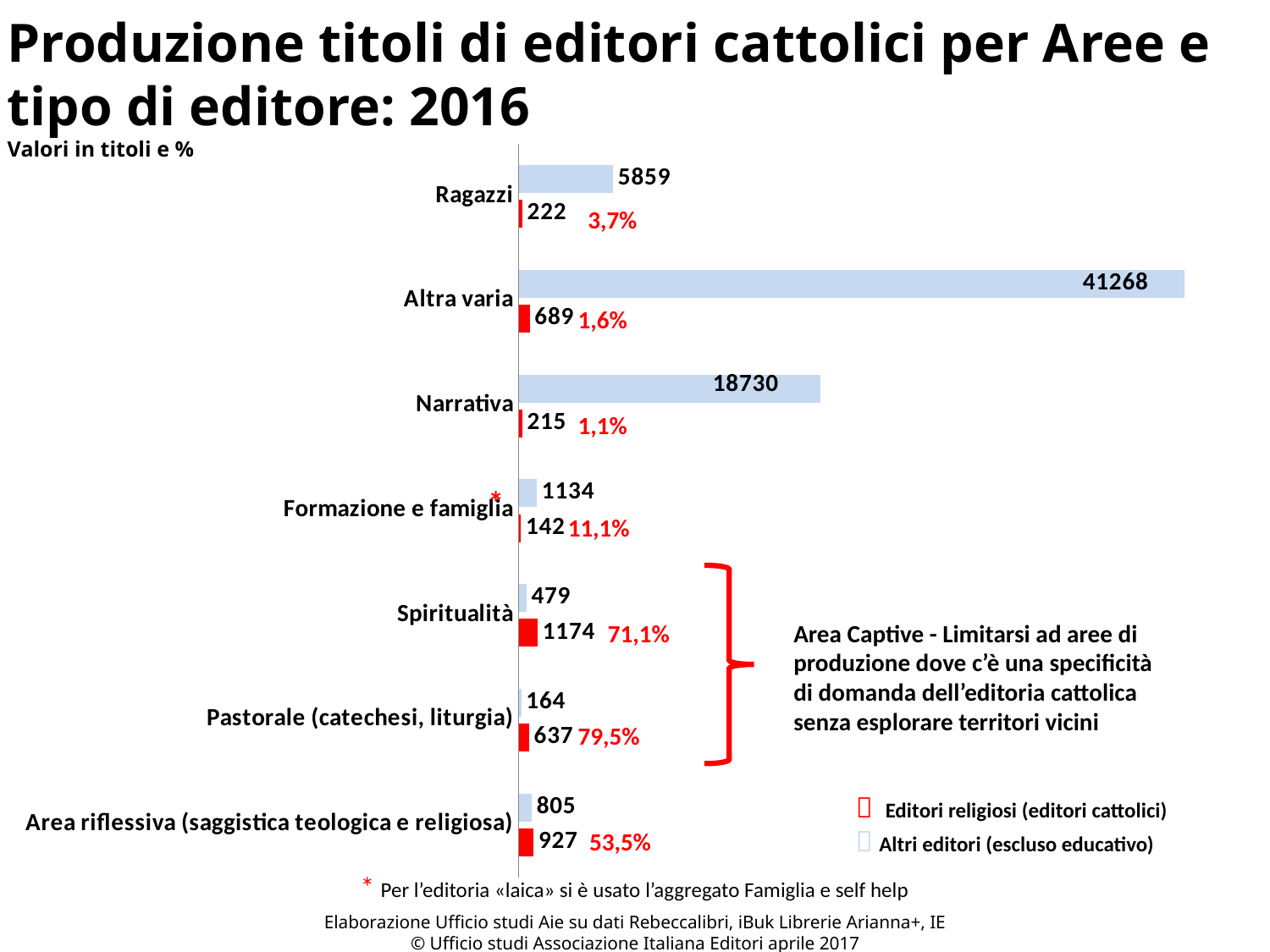
Which category has the highest value for Altri editori (escluso educativo)? Altra varia Which category has the highest value for Editori religiosi (editori cattolici)? Spiritualità Which category has the lowest value for Altri editori (escluso educativo)? Pastorale (catechesi, liturgia) How many series does the legend list? 2 What type of chart is shown on the slide? Bar chart What is the value for Editori religiosi (editori cattolici) in the Spiritualità category? 1174 How many categories are shown on the chart? 7 What percentage is shown next to the Pastorale (catechesi, liturgia) category? 79,5% In the Area riflessiva (saggistica teologica e religiosa) category, which series has the larger value, Editori religiosi or Altri editori? Editori religiosi (editori cattolici) What is the difference between the Altri editori and Editori religiosi values in the Narrativa category? 18515 What is the value for Editori religiosi (editori cattolici) in the Ragazzi category? 222 What is the value for Altri editori (escluso educativo) in the Altra varia category? 41268